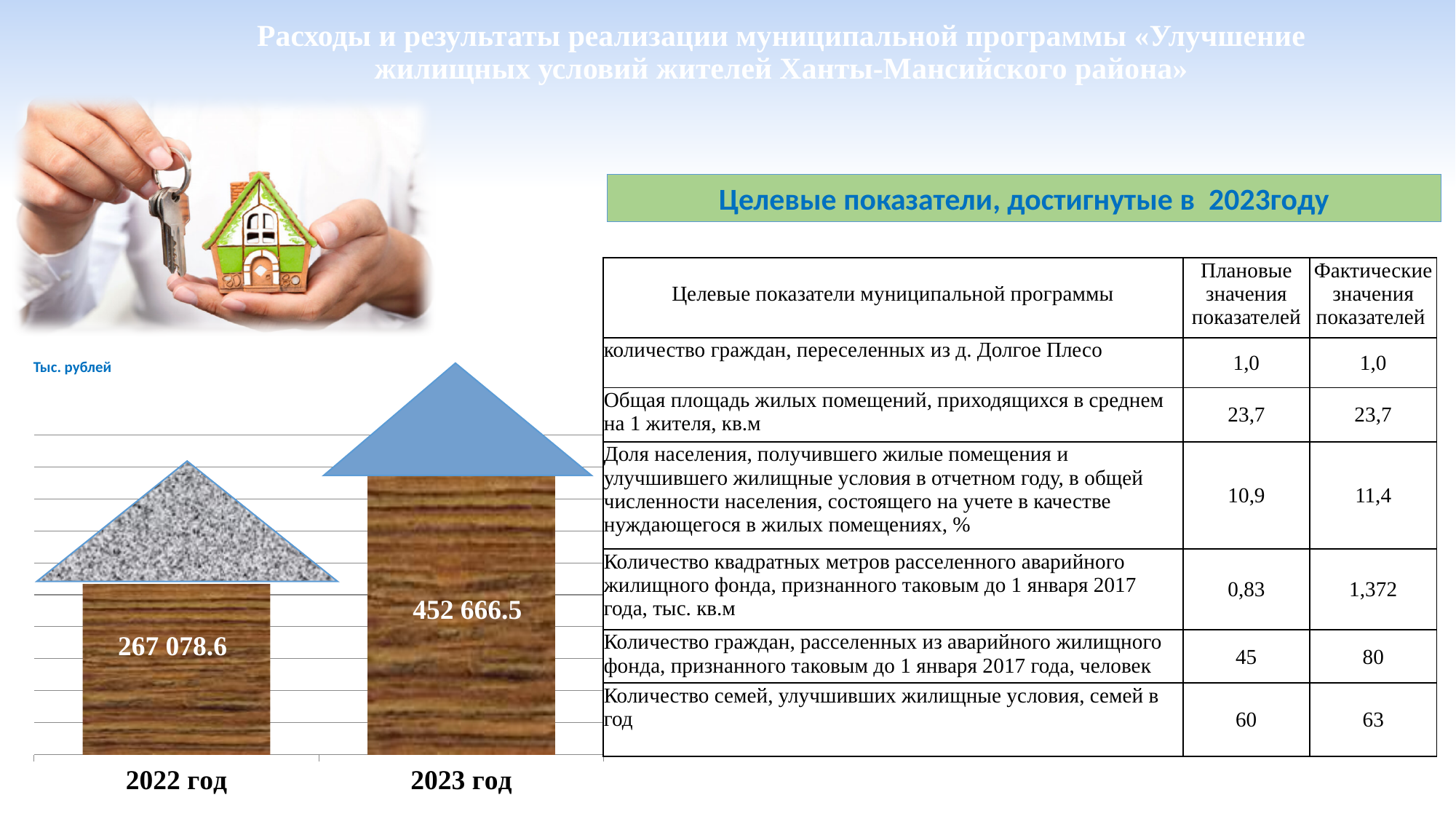
Which year has the lowest value in the bar chart? 2022 год What are the category labels on the x axis of the bar chart? 2022 год, 2023 год Which year has the highest value in the bar chart? 2023 год What is the difference between the values for 2023 год and 2022 год in the bar chart? 185 587.9 How many bars are shown in the bar chart? 2 Do the values in the bar chart rise or fall from 2022 год to 2023 год? rise What is the value for 2022 год in the bar chart? 267 078.6 Which is larger in the bar chart: the value for 2022 год or the value for 2023 год? 2023 год What unit label is shown above the bar chart? Тыс. рублей What is the value for 2023 год in the bar chart? 452 666.5 What kind of chart is shown on the left of the slide? bar chart